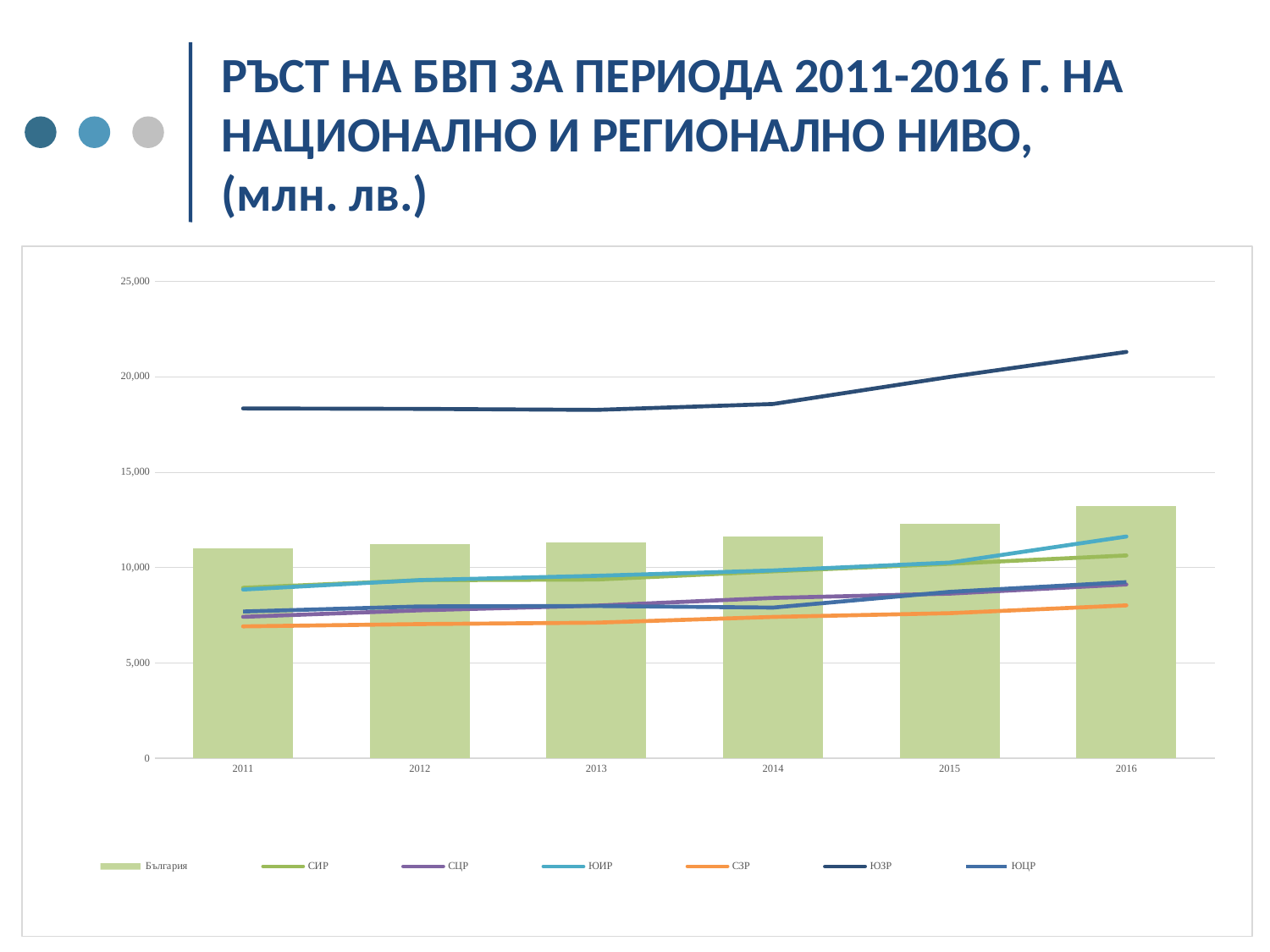
Which series has the highest values across all years? ЮЗР What kind of chart is shown on the slide? Combined bar and line chart Is the value for ЮЗР in 2011 greater or less than 20,000? less Which line series has the lowest value in 2016? СЗР How many years are shown on the x axis of the chart? 6 Which series is plotted as bars rather than a line? България How many series does the chart legend list? 7 Is the value for СЗР in 2011 greater or less than 10,000? less Which is larger in 2016, the value for ЮЗР or the value for България? ЮЗР Does the ЮЗР line rise or fall from 2014 to 2016? rises Is the value for ЮЗР in 2016 greater or less than 20,000? greater